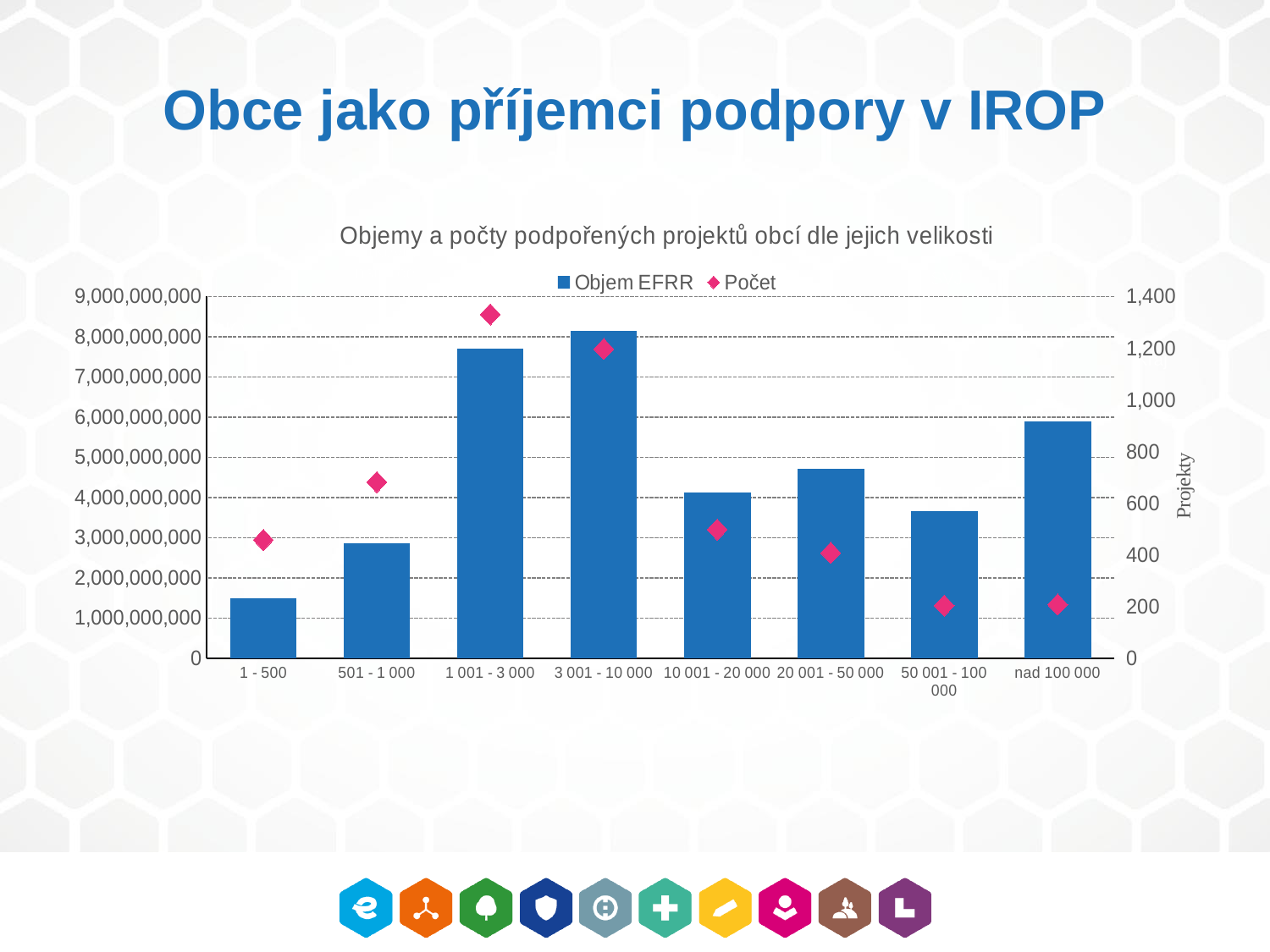
Is the Počet value for 501 - 1 000 greater or less than 600? greater Is the Objem EFRR value for 3 001 - 10 000 greater or less than 8,000,000,000? greater What is the title of the chart? Objemy a počty podpořených projektů obcí dle jejich velikosti Which category has the highest Počet marker? 1 001 - 3 000 Which category has the lowest Objem EFRR bar? 1 - 500 How many series does the chart legend list? 2 Is the Objem EFRR value for 1 - 500 greater or less than 2,000,000,000? less What label is shown on the right-hand vertical axis? Projekty Which category has the highest Objem EFRR bar? 3 001 - 10 000 How many municipality size categories are shown on the x axis? 8 Which has the larger Objem EFRR bar, 20 001 - 50 000 or 10 001 - 20 000? 20 001 - 50 000